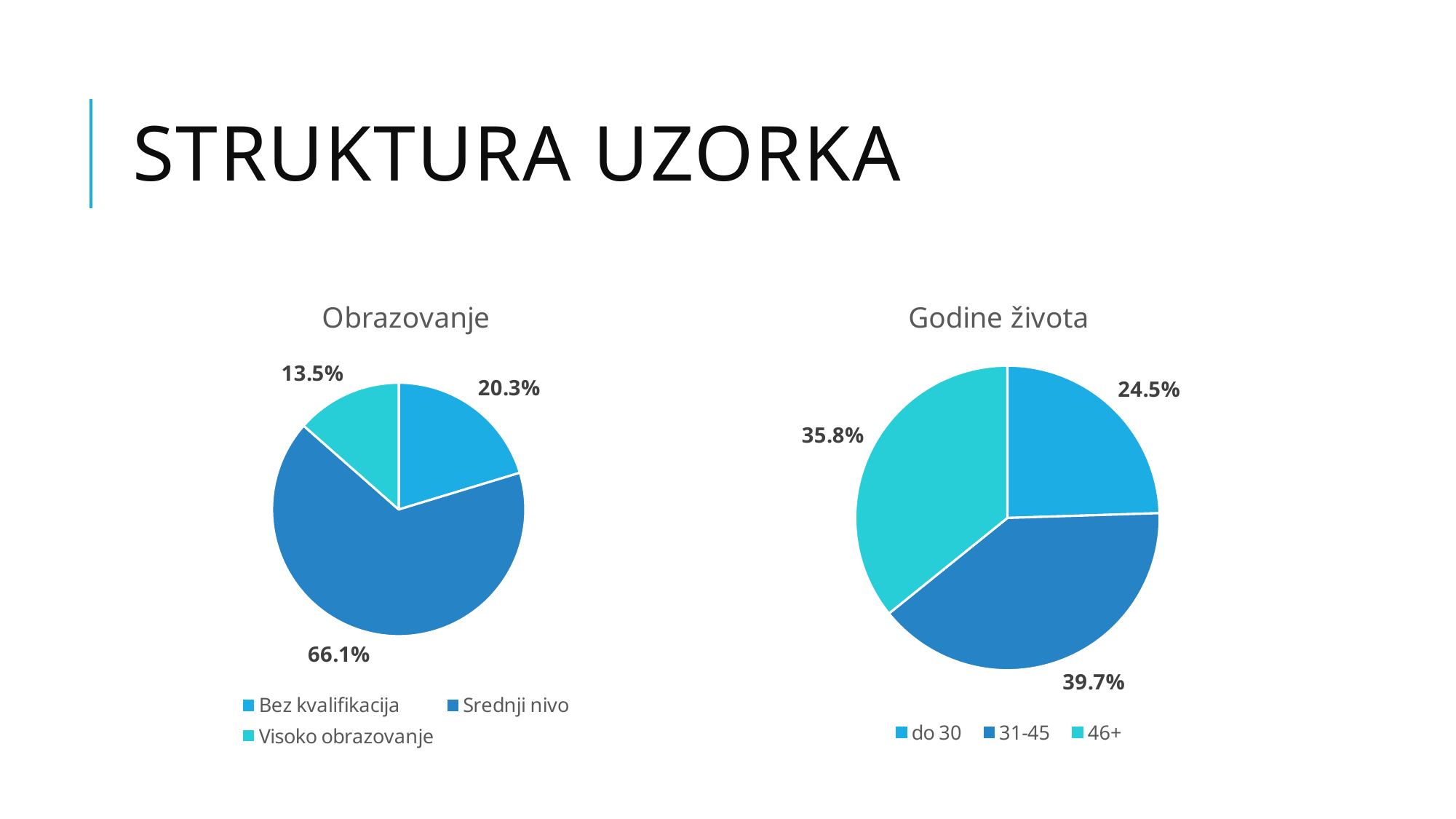
In the "Godine života" chart, which age group has the smallest slice? do 30 In the "Obrazovanje" chart, which category has the smallest slice? Visoko obrazovanje In the "Obrazovanje" chart, what share does "Bez kvalifikacija" have? 20.3% In the "Obrazovanje" chart, what is the difference between the shares of "Srednji nivo" and "Bez kvalifikacija"? 45.8% In the "Godine života" chart, what share does the "46+" group have? 35.8% In the "Obrazovanje" chart, what share does "Visoko obrazovanje" have? 13.5% In the "Godine života" chart, which is larger: the share for "31-45" or the share for "46+"? 31-45 In the "Godine života" chart, what share does the "31-45" group have? 39.7% In the "Obrazovanje" chart, which category has the largest slice? Srednji nivo In the "Obrazovanje" chart, what share does "Srednji nivo" have? 66.1% In the "Godine života" chart, what share does the "do 30" group have? 24.5% What type of chart is the "Godine života" chart? Pie chart